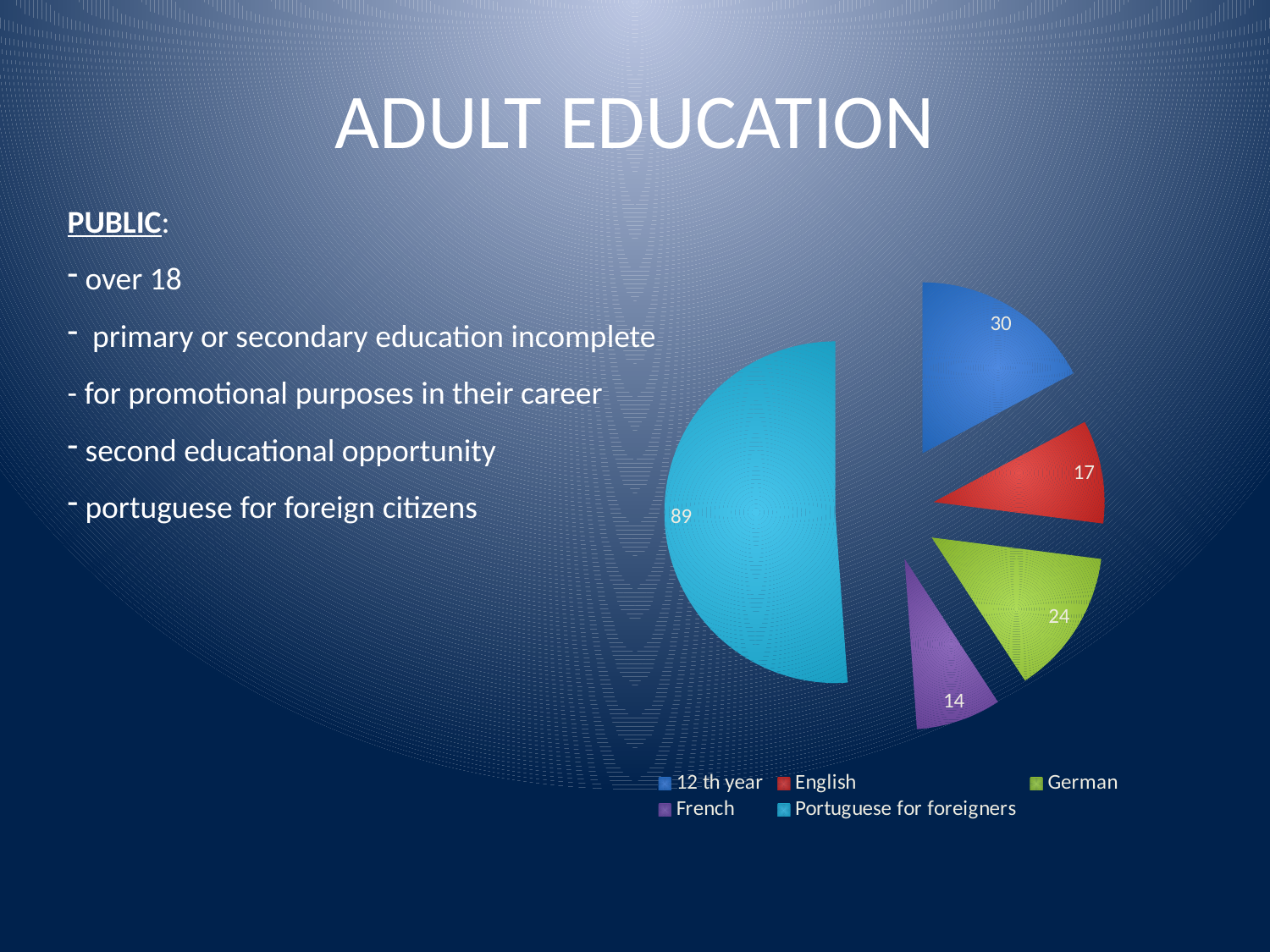
How many categories does the pie chart have? 5 What colour is the slice for Portuguese for foreigners? light blue What is the difference between the values for German and English? 7 What is the value for German? 24 What kind of chart is shown on the slide? pie chart What is the value for French? 14 Which category has the smallest slice? French Which category has the largest slice? Portuguese for foreigners Which is larger, the value for 12 th year or the value for German? 12 th year What is the difference between the values for Portuguese for foreigners and 12 th year? 59 What is the value for Portuguese for foreigners? 89 What is the value for English? 17